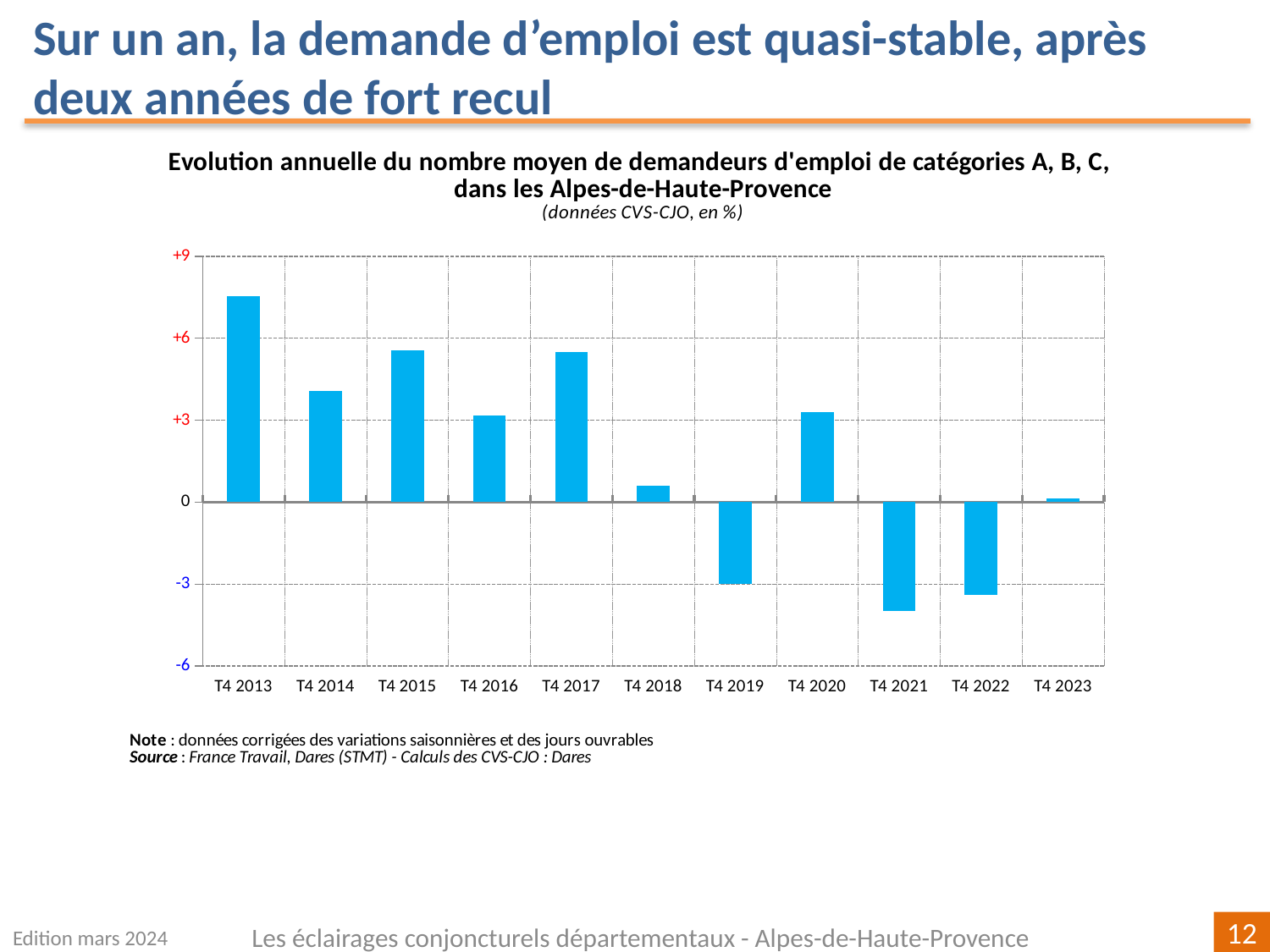
Is the value for T4 2020 positive or negative? positive Is the value for T4 2018 greater or less than +3? less Is the value for T4 2013 greater or less than +6? greater Which is larger, the value for T4 2013 or the value for T4 2014? T4 2013 Which department is named in the chart title? Alpes-de-Haute-Provence What kind of chart is shown on the slide? bar chart Which quarter has the lowest value? T4 2021 Which is larger, the value for T4 2022 or the value for T4 2021? T4 2022 How many quarters (categories) are plotted on the x axis? 11 Which quarter has the highest value? T4 2013